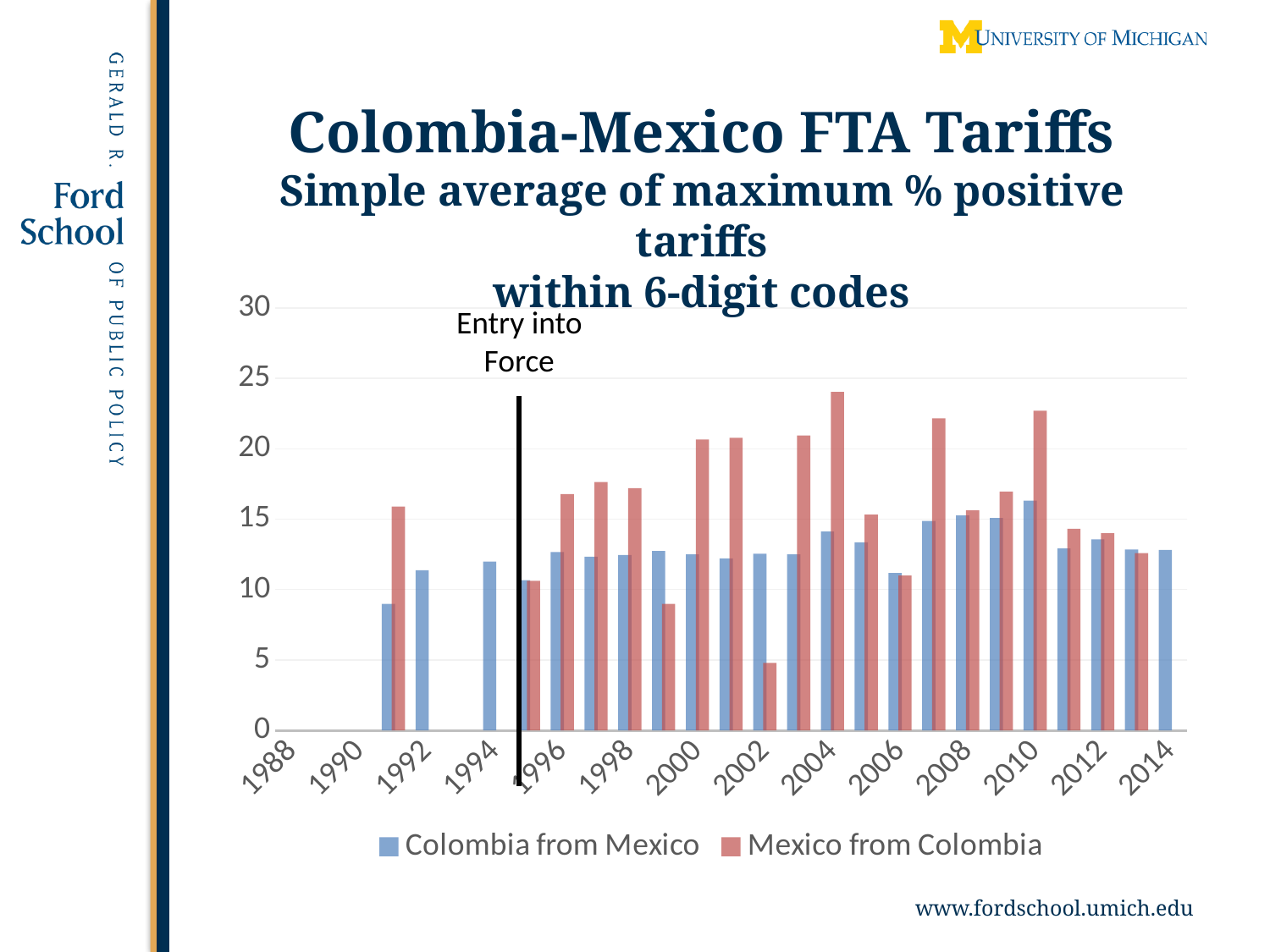
What does the label next to the vertical black line on the chart say? Entry into Force In 2002, which series has the larger value, Colombia from Mexico or Mexico from Colombia? Colombia from Mexico What are the two series named in the legend? Colombia from Mexico; Mexico from Colombia How many series does the legend list? 2 In which year is the Colombia from Mexico value highest? 2010 Is the Mexico from Colombia value for 2002 greater or less than 10? less In which year is the Mexico from Colombia value highest? 2004 Is the Mexico from Colombia value for 2004 greater or less than 20? greater What kind of chart is shown on the slide? bar chart Is the Colombia from Mexico value for 2010 greater or less than 15? greater In 2004, which series has the larger value, Colombia from Mexico or Mexico from Colombia? Mexico from Colombia In which year is the Mexico from Colombia value lowest? 2002